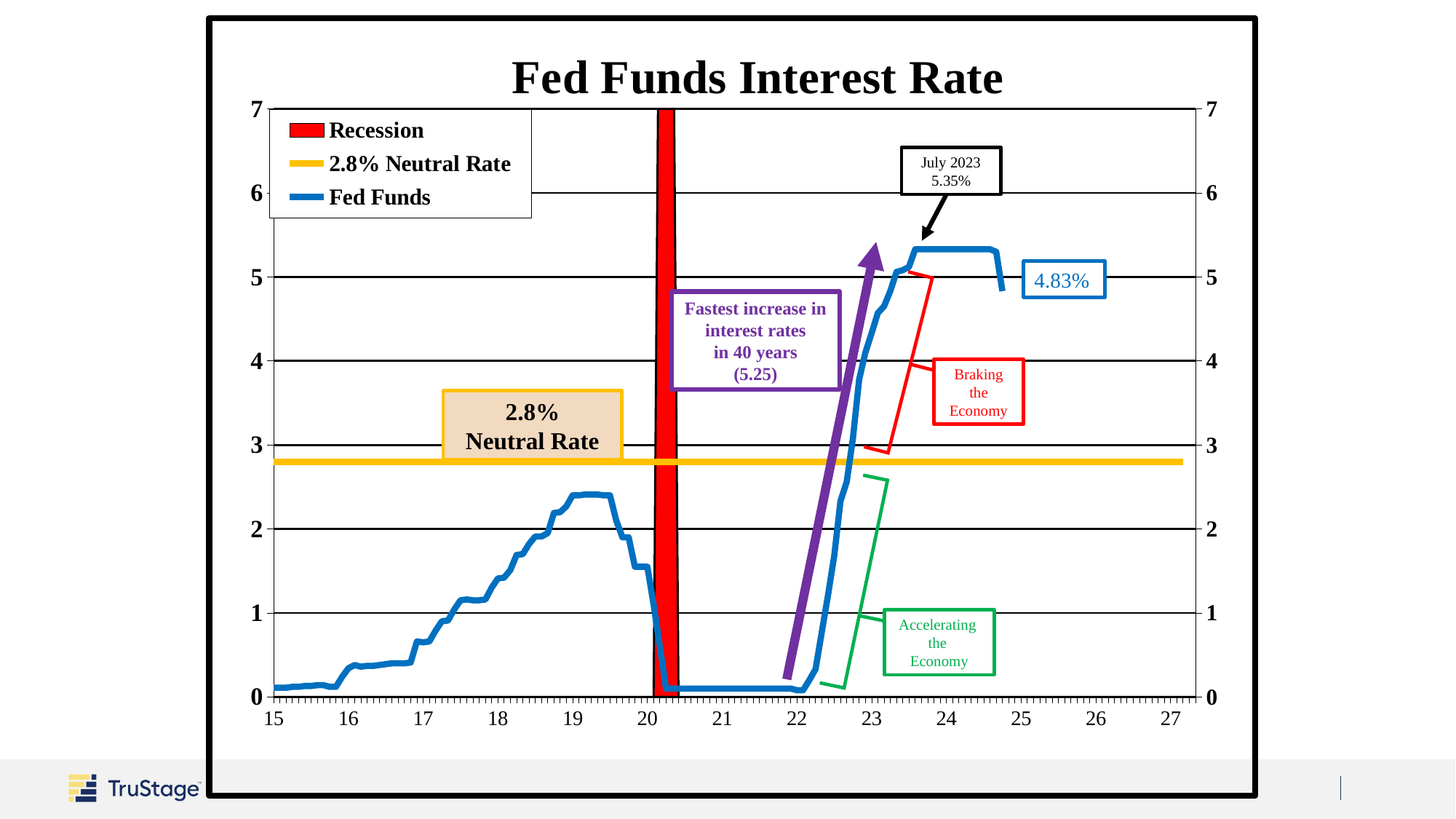
Does the Fed Funds rate rise or fall between 2022 and 2023? rise What is the most recent Fed Funds rate value labelled at the end of the blue line? 4.83% What value is given for the Neutral Rate shown by the yellow line? 2.8% What kind of chart is used to show the Fed Funds rate? line chart What is the difference between the July 2023 rate of 5.35% and the latest labelled rate of 4.83%? 0.52 percentage points Is the Fed Funds rate during 2021 greater or less than 1? less How many entries does the legend list? 3 Is the Fed Funds rate at the start of 2024 greater or less than 5? greater Is the Fed Funds rate at its 2019 peak higher or lower than the 2.8% Neutral Rate line? lower What Fed Funds rate is labelled for July 2023? 5.35% What does the red shaded area on the chart represent, according to the legend? Recession What is the title of the chart? Fed Funds Interest Rate